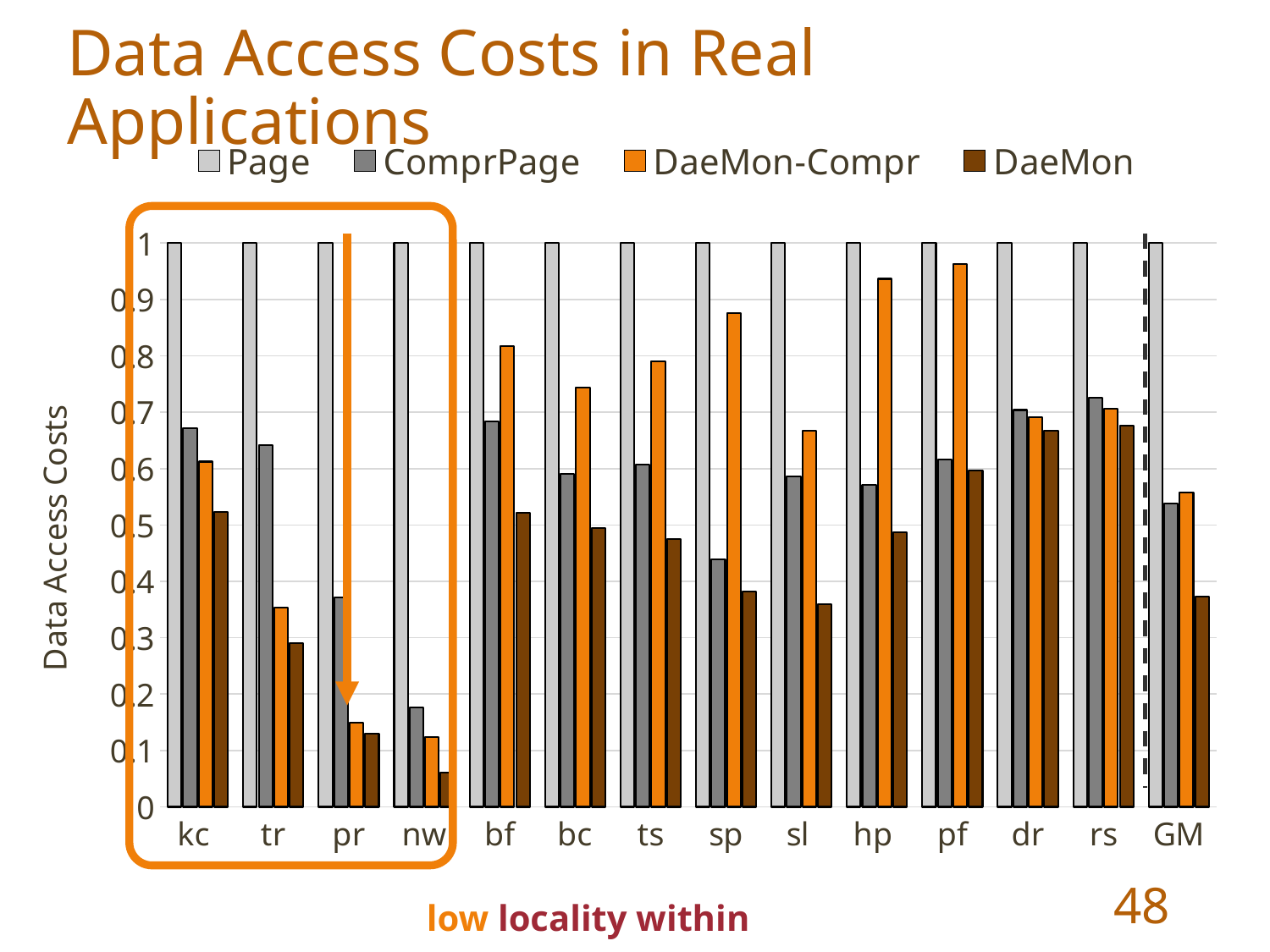
Is the DaeMon value for GM greater or less than 0.4? less What kind of chart is shown on the slide? bar chart Is the ComprPage value for tr greater or less than 0.6? greater Which category has the lowest DaeMon-Compr value? nw How many series does the legend list? 4 What is the Page value for kc? 1 For sp, which is larger: the DaeMon-Compr value or the DaeMon value? DaeMon-Compr Which category has the lowest DaeMon value? nw Is the DaeMon value for nw greater or less than 0.1? less How many categories are shown along the x axis? 14 What is the label of the y axis? Data Access Costs